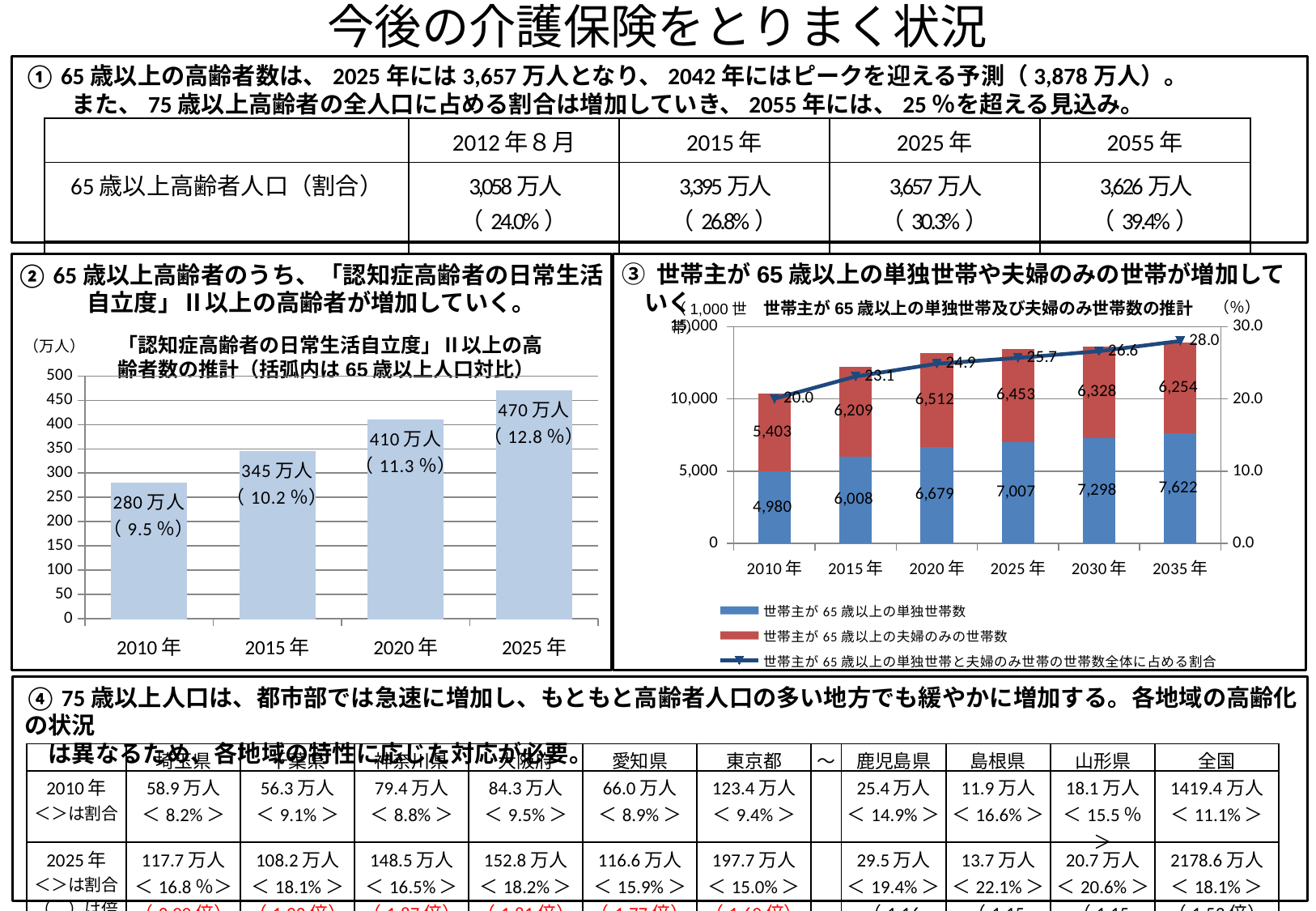
In the right chart (世帯主が65歳以上の単独世帯及び夫婦のみ世帯数の推計), what is the total of the stacked bar for 2010年? 10,383 In the left chart (「認知症高齢者の日常生活自立度」Ⅱ以上の高齢者数の推計), how many years are plotted? 4 In the right chart (世帯主が65歳以上の単独世帯及び夫婦のみ世帯数の推計), how many series does the legend list? 3 In the left chart (「認知症高齢者の日常生活自立度」Ⅱ以上の高齢者数の推計), which year has the lowest value? 2010年 In the right chart (世帯主が65歳以上の単独世帯及び夫婦のみ世帯数の推計), which year has the highest value on the line series (割合)? 2035年 In the right chart (世帯主が65歳以上の単独世帯及び夫婦のみ世帯数の推計), what is the value of 世帯主が65歳以上の夫婦のみの世帯数 for 2015年? 6,209 In the left chart (「認知症高齢者の日常生活自立度」Ⅱ以上の高齢者数の推計), what is the value for 2020年? 410万人 In the left chart (「認知症高齢者の日常生活自立度」Ⅱ以上の高齢者数の推計), what percentage is shown in parentheses for 2025年? 12.8% In the right chart (世帯主が65歳以上の単独世帯及び夫婦のみ世帯数の推計), which is larger in 2025年: 単独世帯数 or 夫婦のみの世帯数? 単独世帯数 In the left chart (「認知症高齢者の日常生活自立度」Ⅱ以上の高齢者数の推計), do the values rise or fall from 2010年 to 2025年? rise In the right chart (世帯主が65歳以上の単独世帯及び夫婦のみ世帯数の推計), what is the value of 世帯主が65歳以上の単独世帯数 for 2035年? 7,622 In the left chart (「認知症高齢者の日常生活自立度」Ⅱ以上の高齢者数の推計), what is the difference between the 2025年 and 2010年 values? 190万人